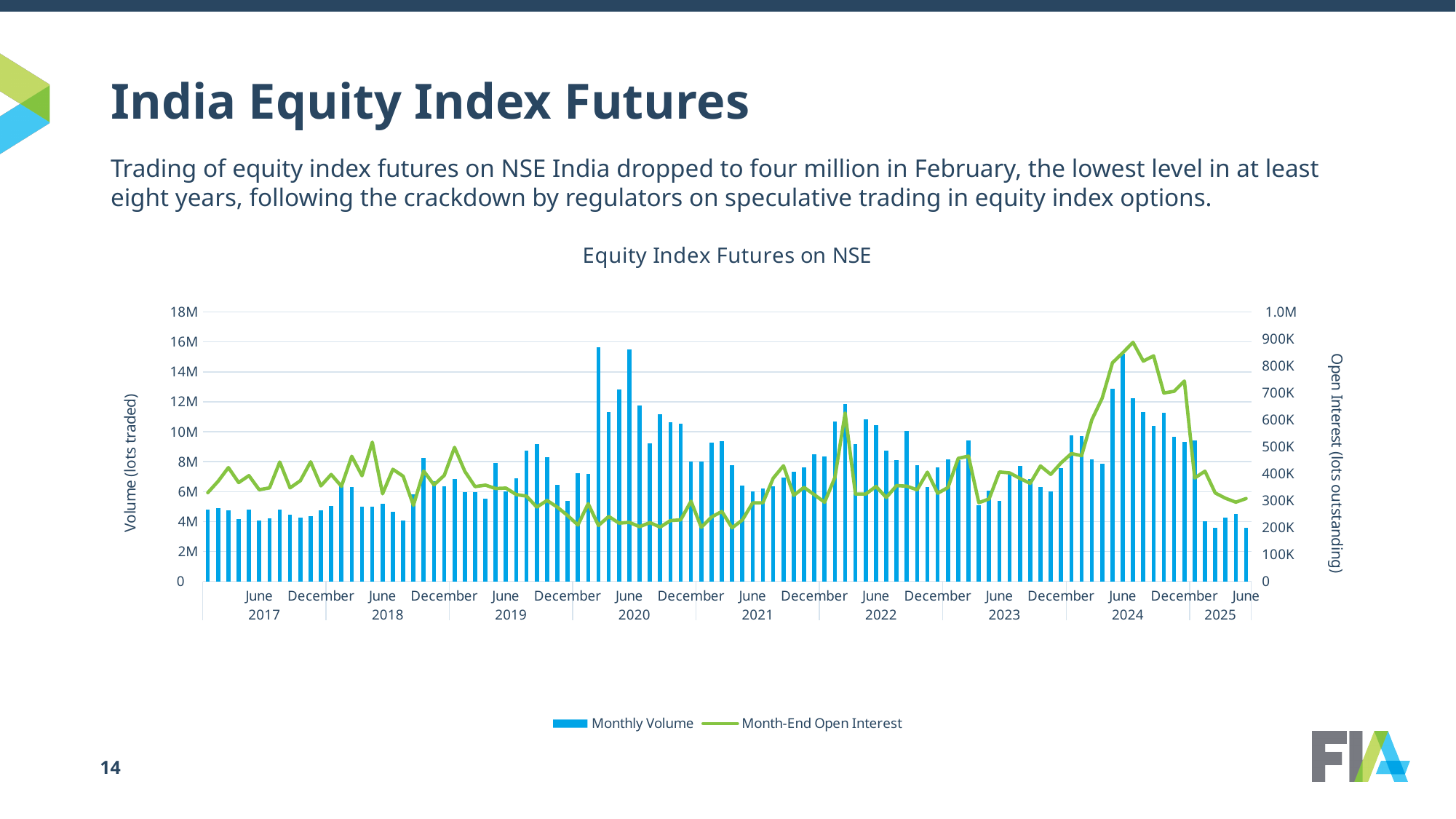
Is the Month-End Open Interest in June 2025 greater or less than 400K? less Is the Monthly Volume in June 2025 greater or less than 6M? less Which is higher, the Monthly Volume in June 2020 or in June 2017? June 2020 Does the Month-End Open Interest rise or fall between June 2024 and June 2025? Fall What is the highest tick shown on the right (open interest) axis? 1.0M What is the title of the chart? Equity Index Futures on NSE Is the Month-End Open Interest at its peak in mid-2024 greater or less than 800K? greater How many series does the chart legend list? 2 Which series is drawn as a green line? Month-End Open Interest What is the highest tick shown on the left (volume) axis? 18M What kind of chart is shown on the slide? A combination bar and line chart